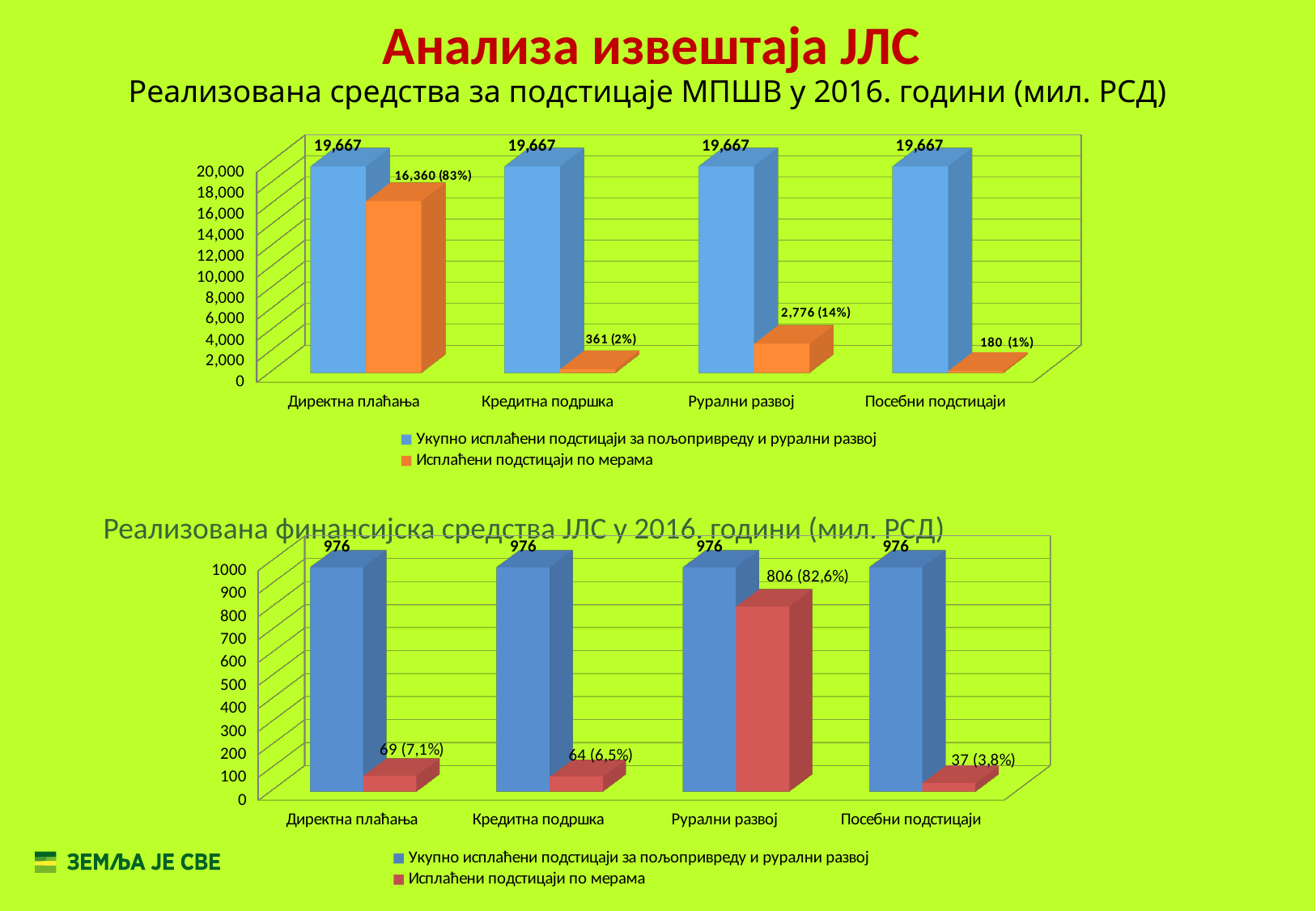
In the top chart (Реализована средства за подстицаје МПШВ у 2016. години), what is the value of Исплаћени подстицаји по мерама for Директна плаћања? 16,360 (83%) In the top chart (Реализована средства за подстицаје МПШВ у 2016. години), what is the difference between Исплаћени подстицаји по мерама for Рурални развој and for Кредитна подршка? 2,415 In the top chart (Реализована средства за подстицаје МПШВ у 2016. години), how many categories are shown on the x axis? 4 In the top chart (Реализована средства за подстицаје МПШВ у 2016. години), what is the value of Исплаћени подстицаји по мерама for Рурални развој? 2,776 (14%) In the top chart (Реализована средства за подстицаје МПШВ у 2016. години), which category has the lowest value of Исплаћени подстицаји по мерама? Посебни подстицаји In the bottom chart (Реализована финансијска средства ЈЛС у 2016. години), how many series does the legend list? 2 What type of chart is the bottom chart (Реализована финансијска средства ЈЛС у 2016. години)? Bar chart In the bottom chart (Реализована финансијска средства ЈЛС у 2016. години), what is the value of Исплаћени подстицаји по мерама for Рурални развој? 806 (82,6%) In the bottom chart (Реализована финансијска средства ЈЛС у 2016. години), which category has the highest value of Исплаћени подстицаји по мерама? Рурални развој In the top chart (Реализована средства за подстицаје МПШВ у 2016. години), what value is shown for Укупно исплаћени подстицаји за пољопривреду и рурални развој for Кредитна подршка? 19,667 In the bottom chart (Реализована финансијска средства ЈЛС у 2016. години), which is larger: Исплаћени подстицаји по мерама for Директна плаћања or for Кредитна подршка? Директна плаћања In the bottom chart (Реализована финансијска средства ЈЛС у 2016. години), what is the value of Исплаћени подстицаји по мерама for Посебни подстицаји? 37 (3,8%)